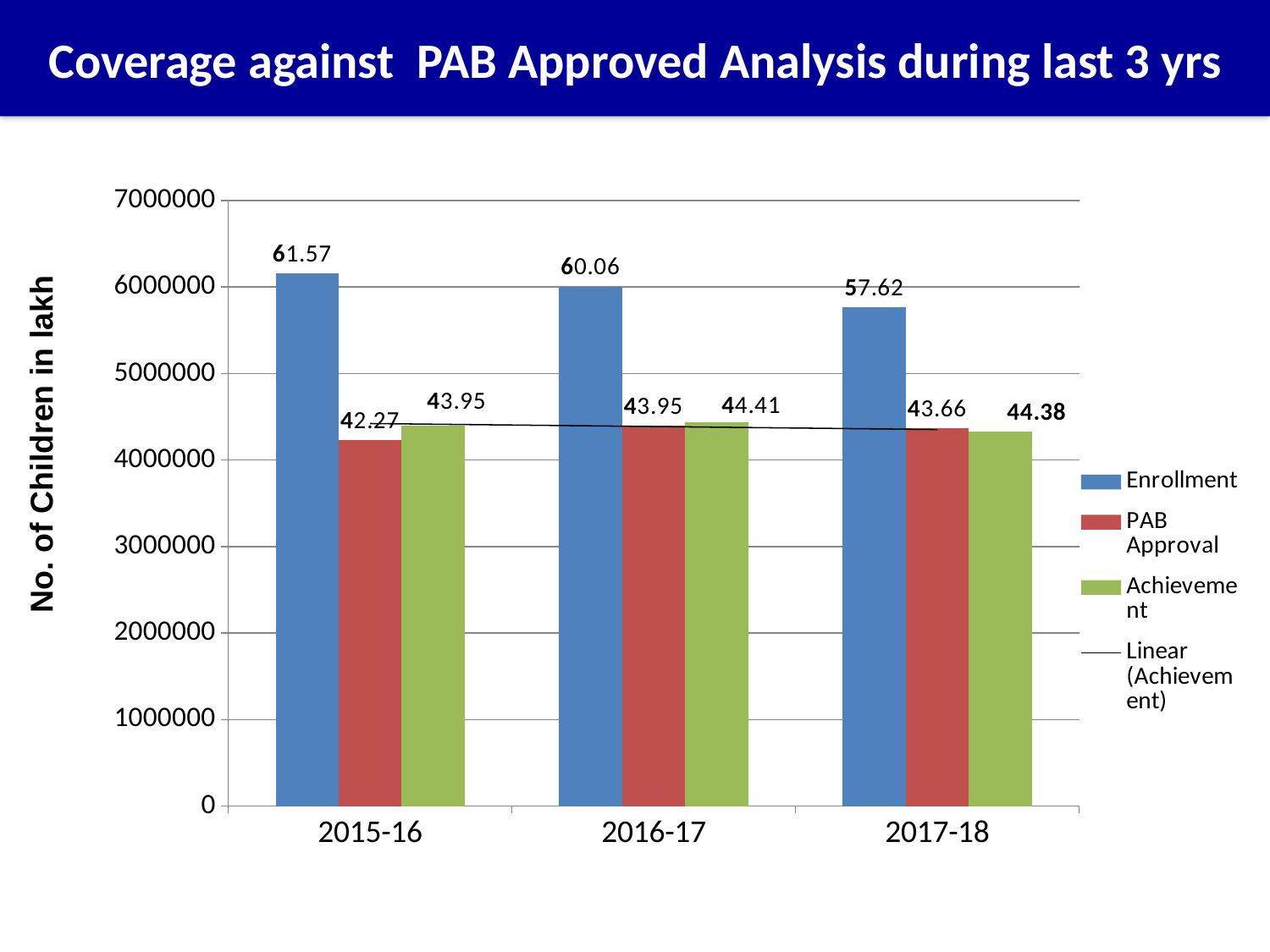
In which year is PAB Approval the lowest? 2015-16 How many entries does the legend list? 4 In which year is Enrollment the highest? 2015-16 What is the PAB Approval value for 2017-18? 43.66 What is the Achievement value for 2016-17? 44.41 What is the difference between Enrollment in 2016-17 and Enrollment in 2017-18? 2.44 Does Enrollment rise or fall from 2015-16 to 2017-18? fall What is the Enrollment value for 2015-16? 61.57 How many years are shown on the x axis? 3 What is the difference between Enrollment and PAB Approval in 2015-16? 19.30 Is the Enrollment bar for 2015-16 greater or less than 6000000 on the axis? greater